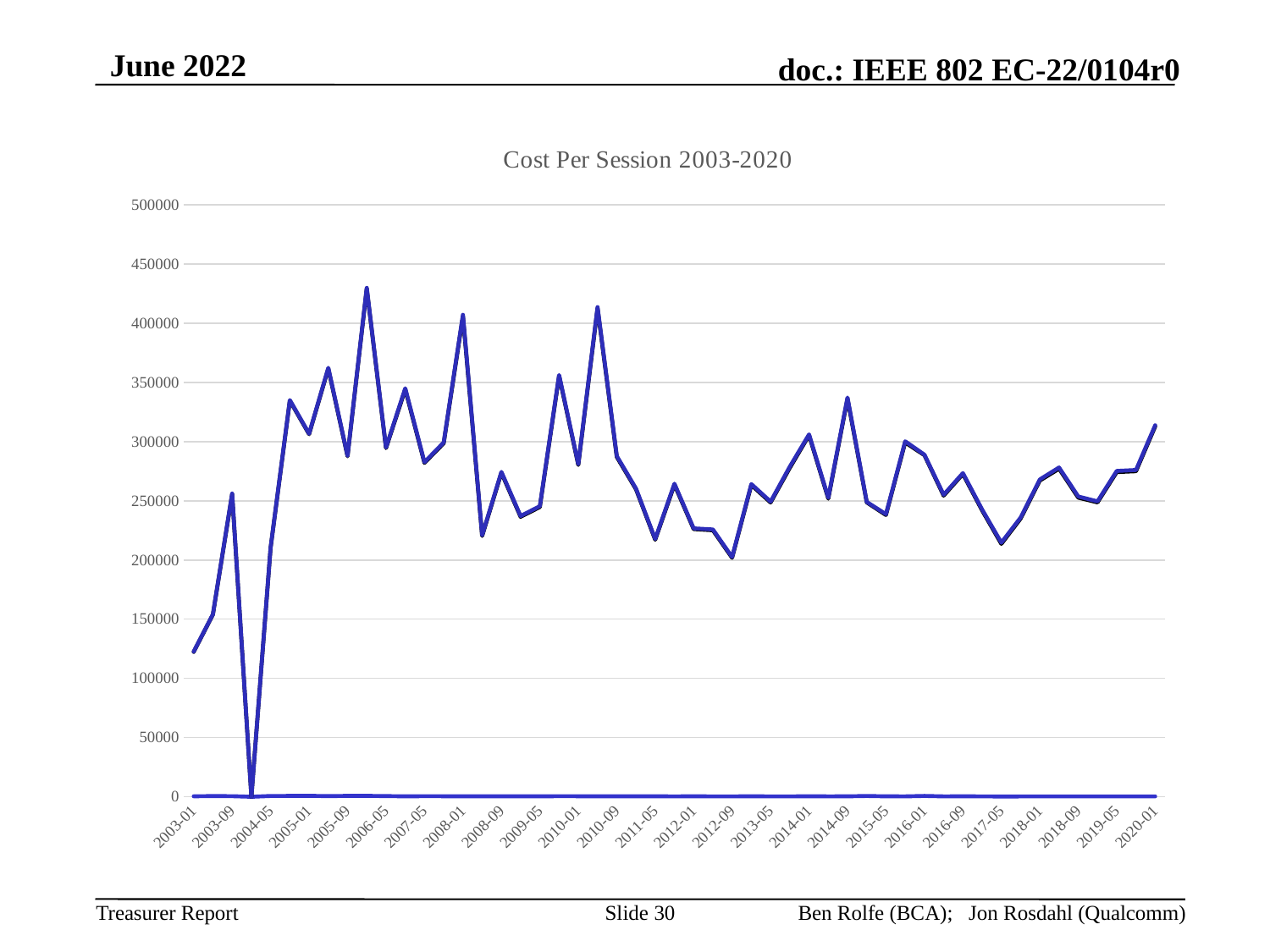
Is the value for 2020-01 greater or less than 300000? greater What is the highest value shown on the vertical axis of the chart? 500000 Is the value for 2006-05 greater or less than 400000? less What is the title of the chart? Cost Per Session 2003-2020 Is the value for 2003-01 greater or less than 150000? less Which has the larger value, 2014-09 or 2017-05? 2014-09 Does the line rise or fall between 2003-01 and 2003-09? rise What kind of chart is shown on the slide? line chart Which has the larger value, 2003-01 or 2020-01? 2020-01